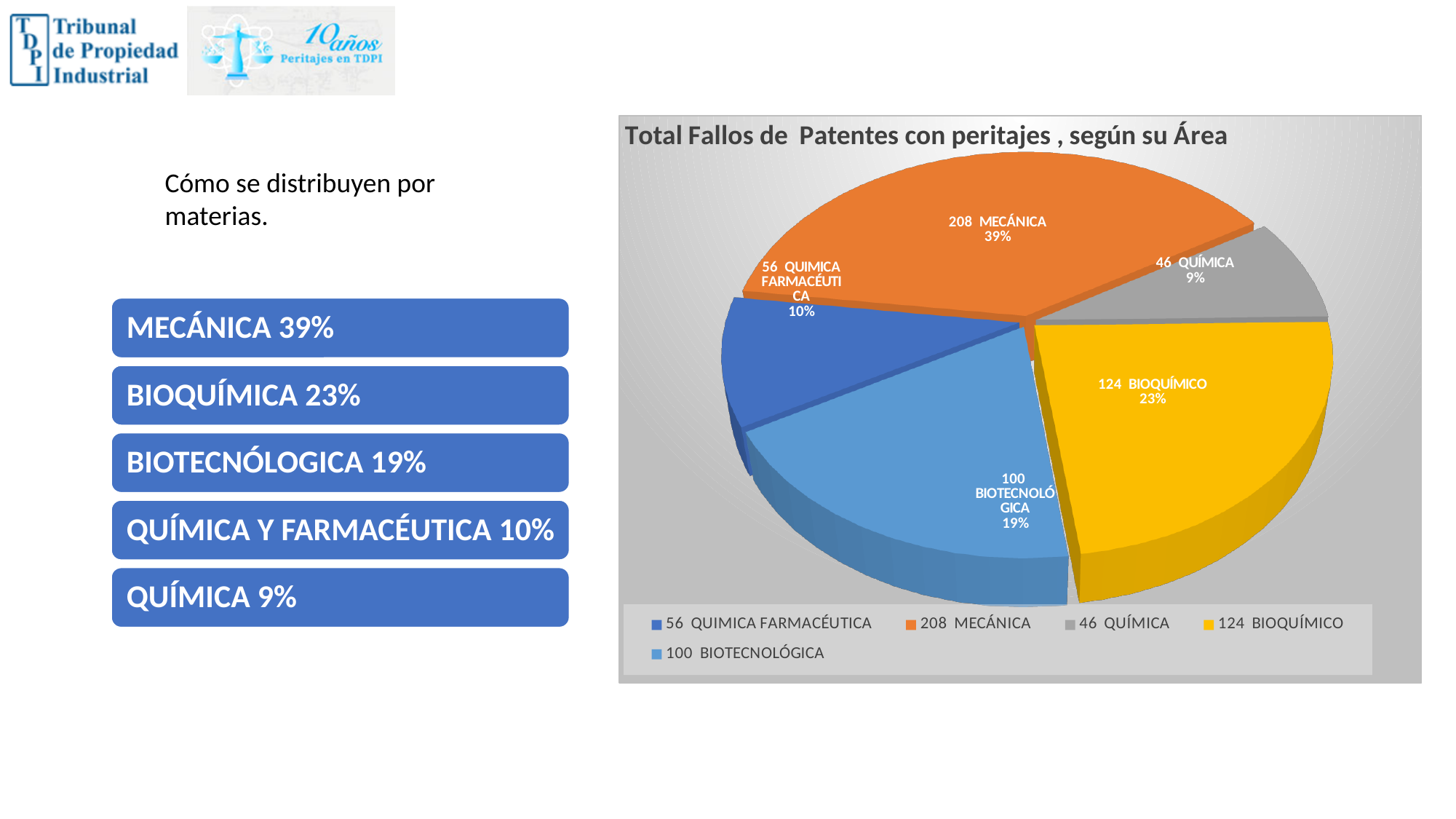
What is the difference between the counts for MECÁNICA and BIOQUÍMICO? 84 How many slices does the pie chart have? 5 What percentage share does the MECÁNICA slice represent? 39% What type of chart is shown on the slide? Pie chart What percentage share does the BIOTECNOLÓGICA slice represent? 19% Which category has the smallest slice? QUÍMICA Which is larger, the count for QUIMICA FARMACÉUTICA or the count for QUÍMICA? QUIMICA FARMACÉUTICA What is the count shown for QUÍMICA? 46 What is the title of the chart? Total Fallos de Patentes con peritajes , según su Área Which category has the largest slice? MECÁNICA What is the count shown for BIOQUÍMICO? 124 What colour is the BIOQUÍMICO slice? Yellow